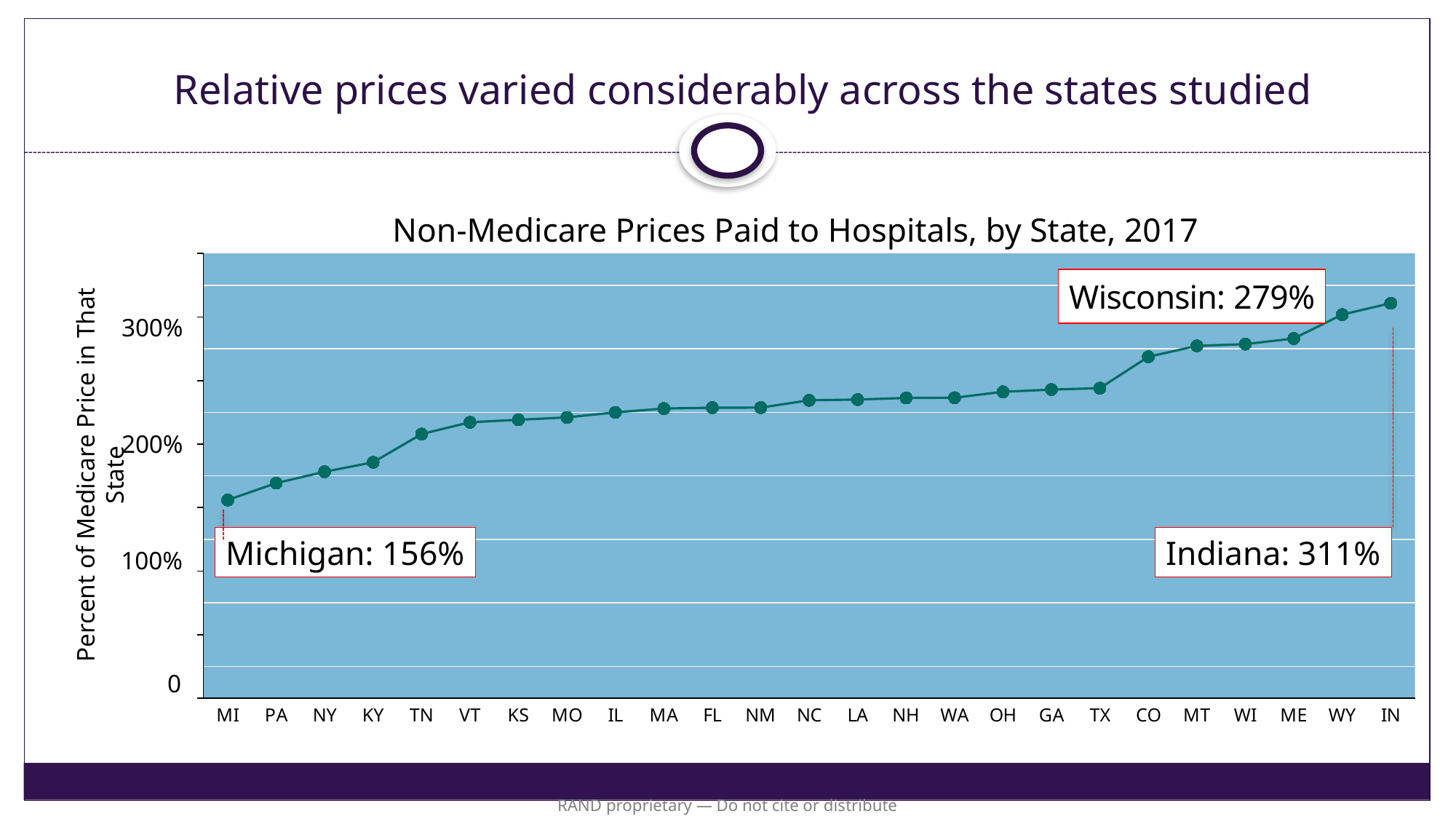
How many states are plotted on the chart? 25 What is the value for Michigan? 156% What type of chart is shown on the slide? Line chart What is the value for Indiana? 311% What is the title of the chart? Non-Medicare Prices Paid to Hospitals, by State, 2017 What is the difference between the values for Indiana and Michigan? 155 percentage points What is the difference between the values for Indiana and Wisconsin? 32 percentage points Which state has the highest value? IN Do the values rise or fall from left to right along the x axis? Rise What is the value for Wisconsin? 279% Which state has the lowest value? MI Is the value for KY greater or less than 200%? less